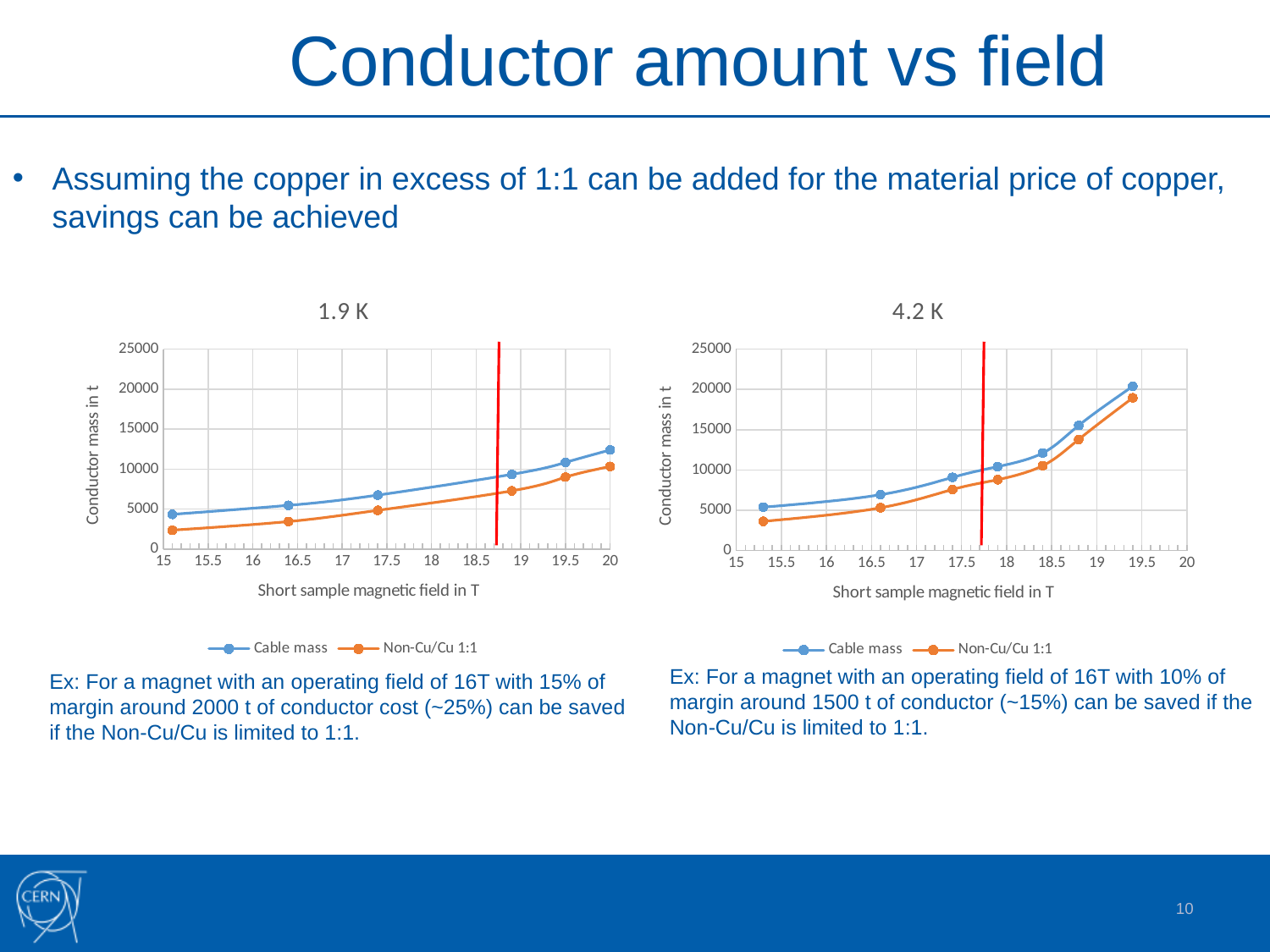
In the 4.2 K chart, is the Non-Cu/Cu 1:1 value at the lowest field point greater or less than 5000? less In the 1.9 K chart, is the Cable mass value at 20 T greater or less than 10000? greater What type of chart is the 1.9 K chart? line chart In the 1.9 K chart, how many data points does the Cable mass series have? 6 How many series does the legend of the 4.2 K chart list? 2 In the 1.9 K chart, is the Cable mass value at the lowest field point greater or less than 5000? less In the 1.9 K chart, does the Cable mass series rise or fall as the short sample magnetic field increases? rise In the 4.2 K chart, how many data points does the Cable mass series have? 7 What is the y-axis label of the 1.9 K chart? Conductor mass in t In the 4.2 K chart, does the Non-Cu/Cu 1:1 series rise or fall along the x axis? rise In the 4.2 K chart, which series has the larger value at the highest field point, Cable mass or Non-Cu/Cu 1:1? Cable mass